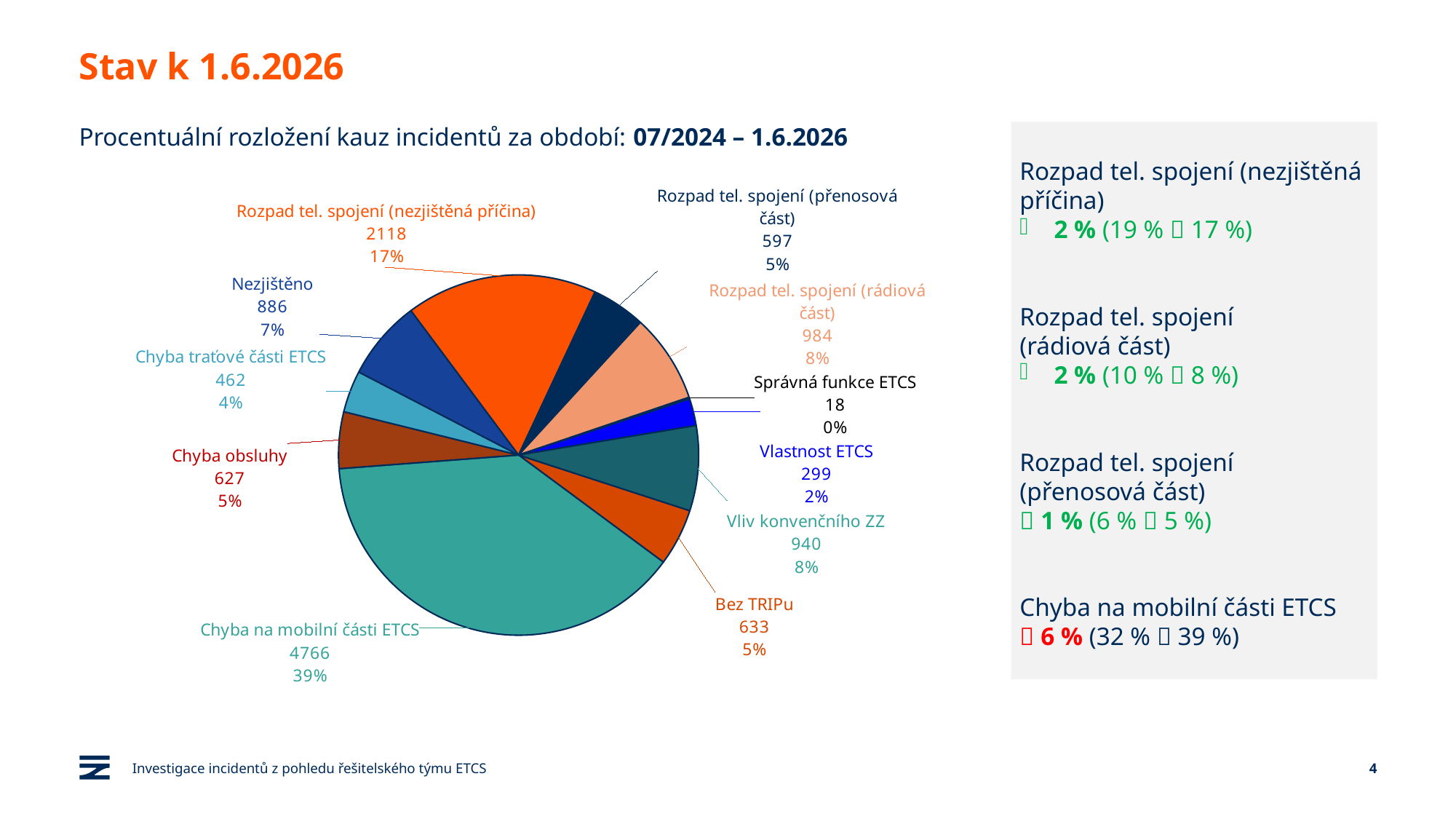
What is the value for Vlastnost ETCS? 299 What share of the pie does Rozpad tel. spojení (rádiová část) represent? 8% What is the value for Rozpad tel. spojení (nezjištěná příčina)? 2118 Which is larger, the value for Bez TRIPu or the value for Chyba obsluhy? Bez TRIPu What is the difference between the values for Vliv konvenčního ZZ and Nezjištěno? 54 What period does the chart's subtitle say the incident distribution covers? 07/2024 – 1.6.2026 What share of the pie does Chyba na mobilní části ETCS represent? 39% How many categories (slices) does the pie chart have? 11 Which category has the smallest slice in the pie chart? Správná funkce ETCS Which category has the largest slice in the pie chart? Chyba na mobilní části ETCS What is the value for Chyba na mobilní části ETCS in the pie chart? 4766 What kind of chart is shown on the slide? pie chart